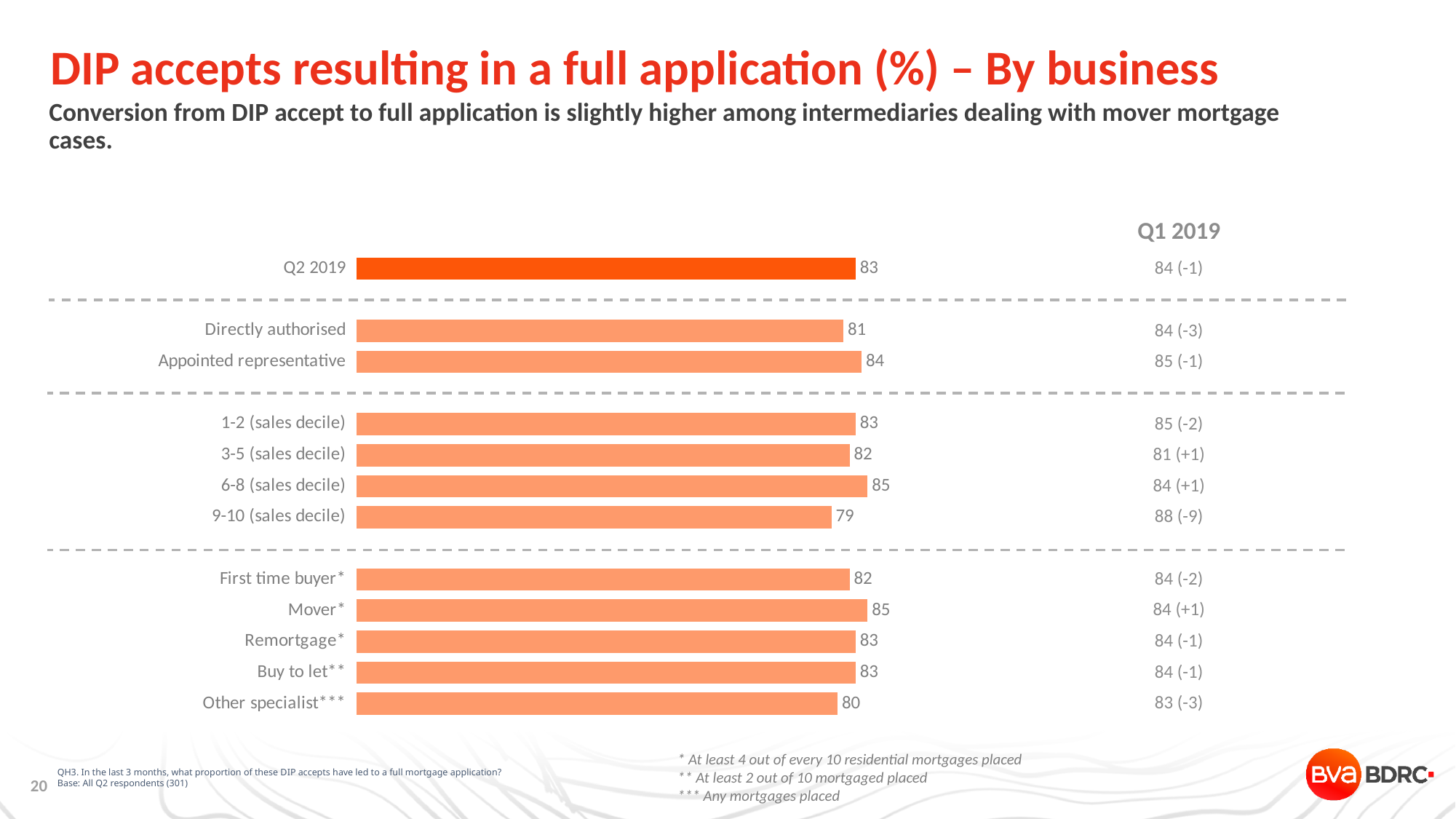
Which is larger, the value for Directly authorised or Appointed representative? Appointed representative What is the value for Other specialist? 80 Which is larger, the value for 6-8 (sales decile) or 9-10 (sales decile)? 6-8 (sales decile) Which category has the lowest value? 9-10 (sales decile) What is the value for Appointed representative? 84 What is the value for Q2 2019 overall? 83 How many bars are plotted in the chart? 12 What Q1 2019 value is shown for 9-10 (sales decile)? 88 (-9) What is the difference between the values for Mover and First time buyer? 3 What kind of chart is shown on the slide? Bar chart What is the value for 9-10 (sales decile)? 79 What is the difference between the values for Appointed representative and Directly authorised? 3